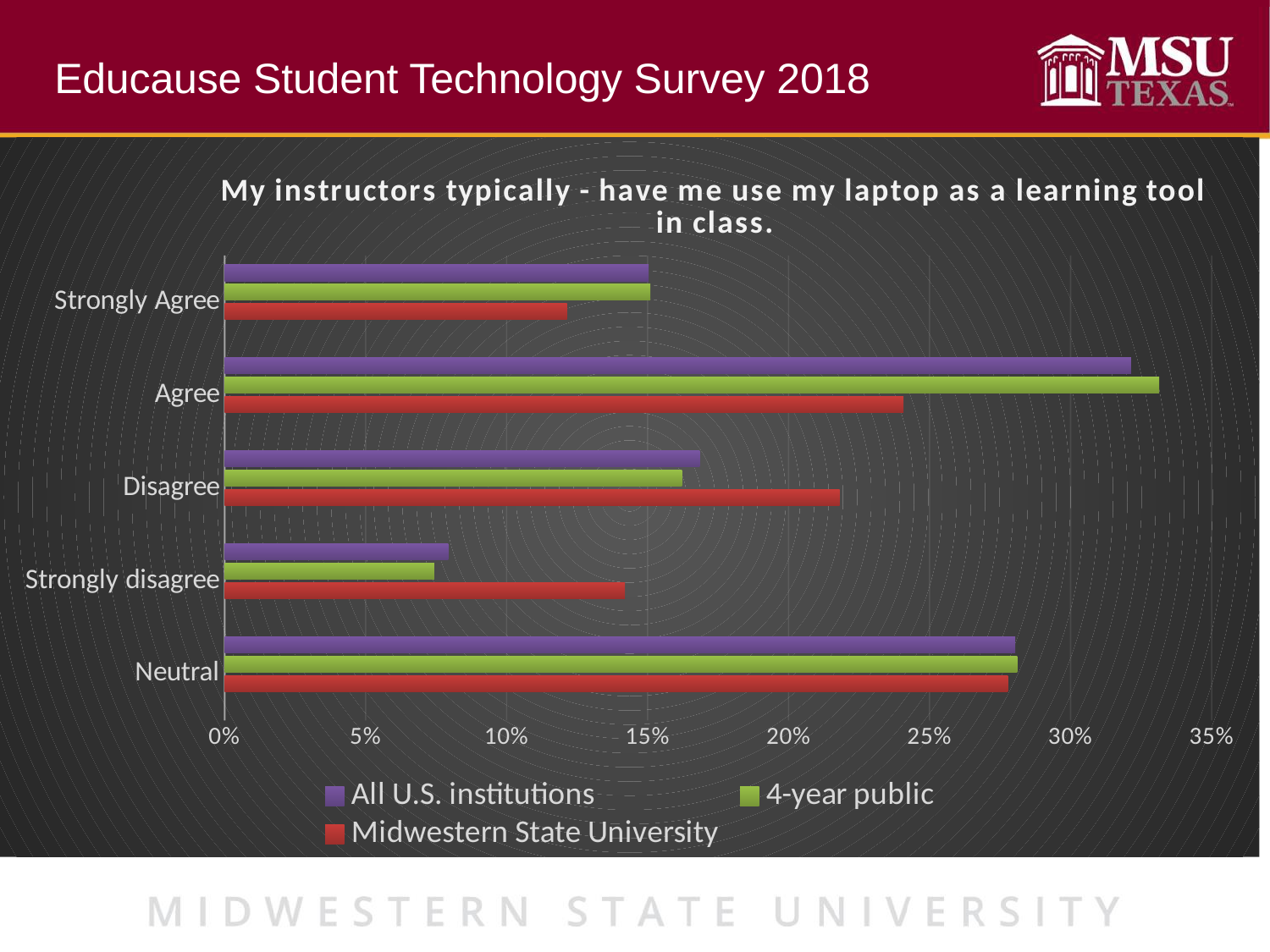
Which response category has the highest value for Midwestern State University? Neutral Which response category has the highest value for 4-year public? Agree What kind of chart is shown on the slide? Bar chart Is the value for 4-year public in the Agree category greater or less than 30%? greater In the Disagree category, which is larger: Midwestern State University or All U.S. institutions? Midwestern State University How many response categories are shown on the y axis of the chart? 5 What colour represents Midwestern State University in the chart? Red In the Agree category, which is larger: 4-year public or Midwestern State University? 4-year public How many series does the chart's legend list? 3 Which response category has the lowest value for All U.S. institutions? Strongly disagree Is the value for Midwestern State University in the Agree category greater or less than 20%? greater Is the value for All U.S. institutions in the Strongly disagree category greater or less than 10%? less